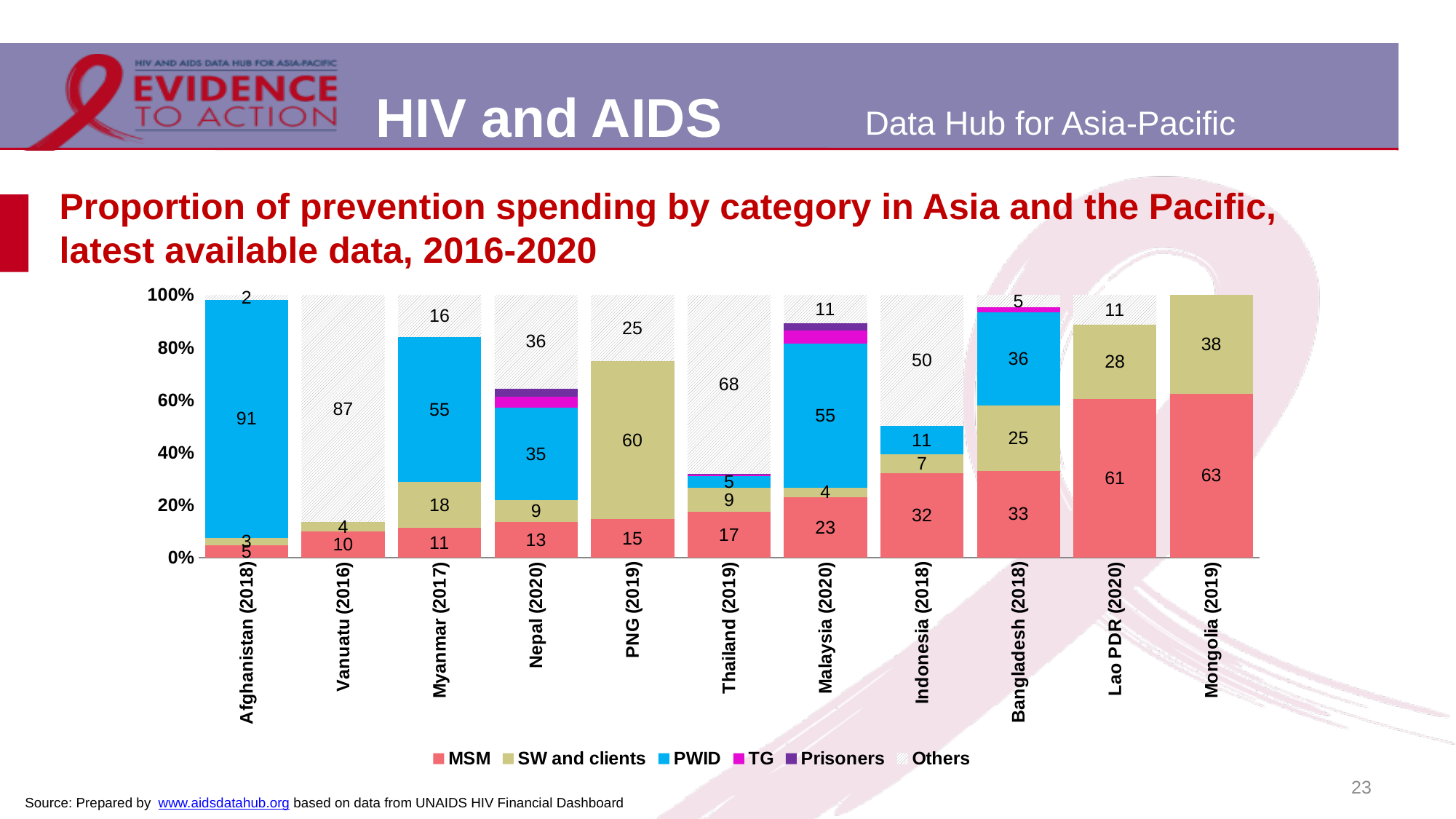
How many series does the legend list? 6 What is the difference between the MSM share for Lao PDR (2020) and the MSM share for Bangladesh (2018)? 28 What is the SW and clients share of prevention spending for PNG (2019)? 60 Does the MSM share of prevention spending rise or fall moving from left to right across the countries? Rise What kind of chart is shown on the slide? Stacked bar chart How many countries are shown on the x axis of the chart? 11 What is the PWID share of prevention spending for Afghanistan (2018)? 91 What is the Others share of prevention spending for Thailand (2019)? 68 Which is larger: the PWID share for Myanmar (2017) or the PWID share for Nepal (2020)? Myanmar (2017) Which country has the lowest MSM share of prevention spending? Afghanistan (2018) Which country has the highest MSM share of prevention spending? Mongolia (2019) Which legend entry is shown in blue? PWID